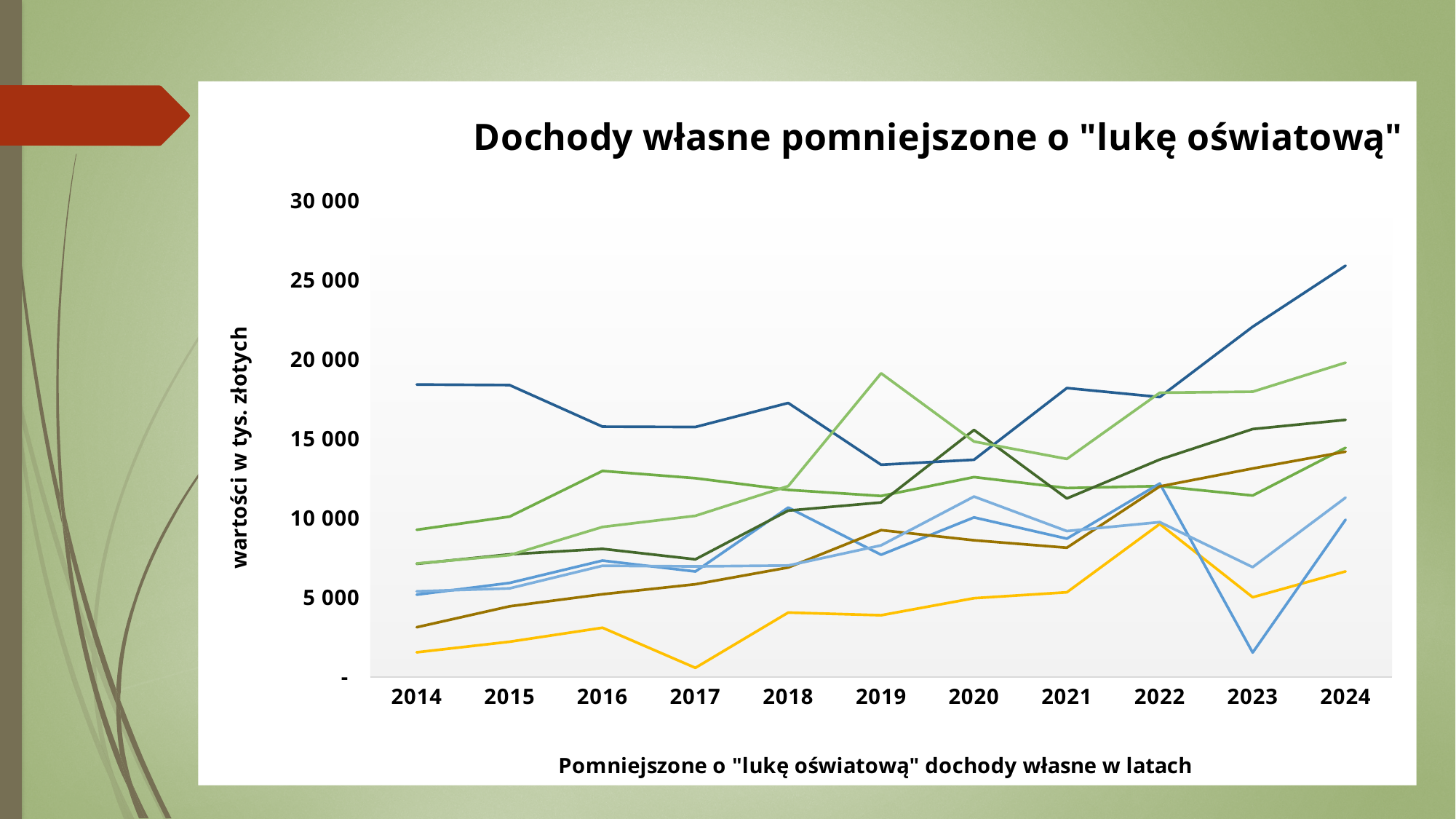
How many years are shown on the x axis? 11 What is the label of the vertical axis? wartości w tys. złotych What is the first year shown on the x axis? 2014 What is the maximum value shown on the vertical axis? 30 000 Is the lowest value plotted in 2017 greater or less than 5 000? less What is the last year shown on the x axis? 2024 Is the highest value plotted in 2024 greater or less than 25 000? greater How many lines are plotted on the chart? 8 Is the highest value plotted in 2014 greater or less than 20 000? less What kind of chart is shown on the slide? line chart What is the title of the chart? Dochody własne pomniejszone o "lukę oświatową"